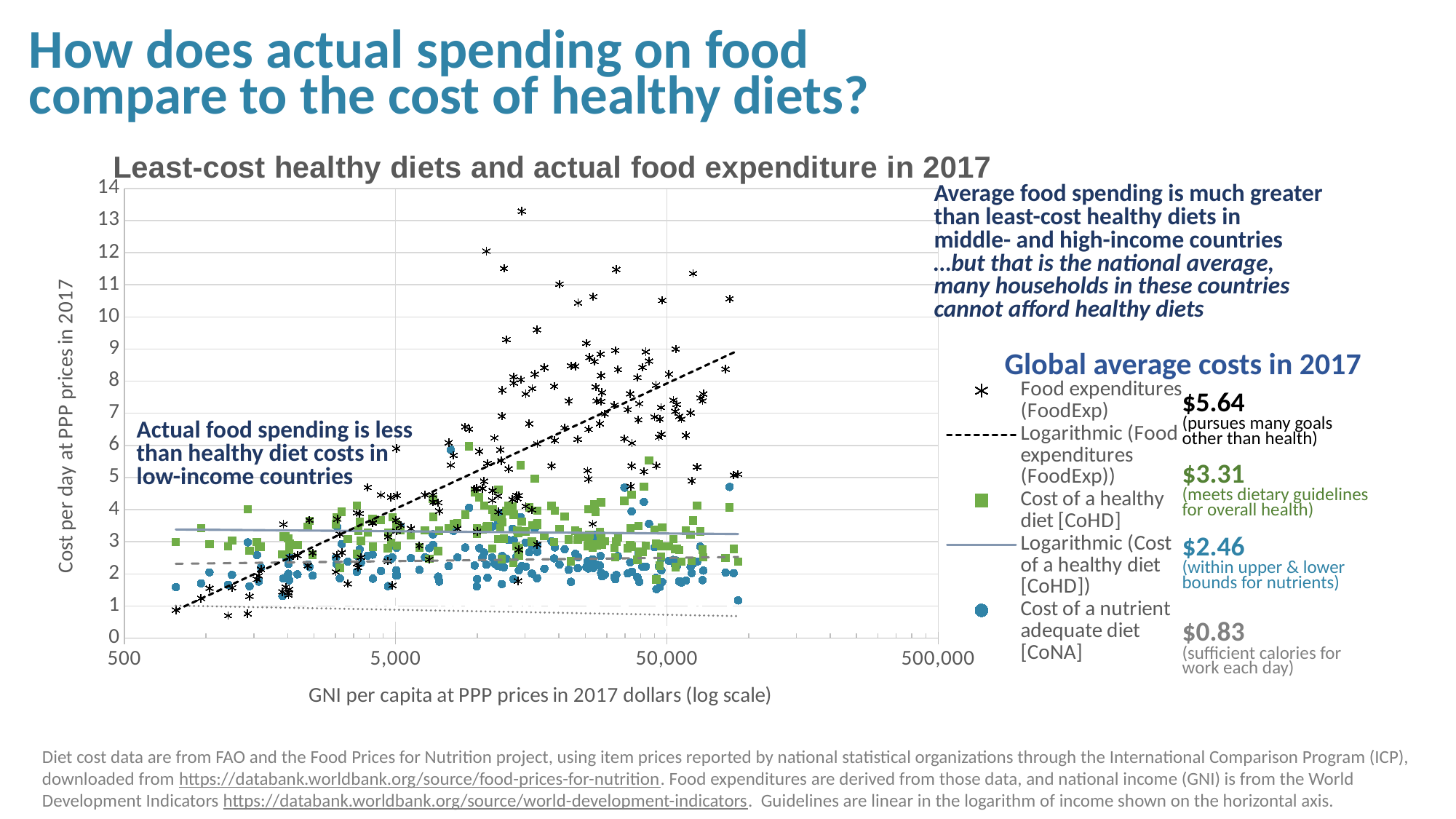
How many entries does the chart legend list? 5 What kind of chart is shown on the slide? scatter chart Which of the global average costs in 2017 is the highest? Food expenditures (FoodExp), $5.64 Which of the global average costs in 2017 is the lowest? $0.83 (sufficient calories for work each day) What is the global average cost in 2017 for food expenditures (FoodExp)? $5.64 What is the difference between the global average food expenditure ($5.64) and the global average cost of a healthy diet ($3.31)? $2.33 What is the global average cost in 2017 of a nutrient adequate diet (CoNA)? $2.46 What is the global average cost in 2017 of a healthy diet (CoHD)? $3.31 Which is larger: the global average cost of a healthy diet (CoHD) or the global average cost of a nutrient adequate diet (CoNA)? Cost of a healthy diet (CoHD) Does the logarithmic trend line for food expenditures (FoodExp) rise or fall as GNI per capita increases? rise What is the label of the horizontal axis of the chart? GNI per capita at PPP prices in 2017 dollars (log scale) What is the title of the chart? Least-cost healthy diets and actual food expenditure in 2017